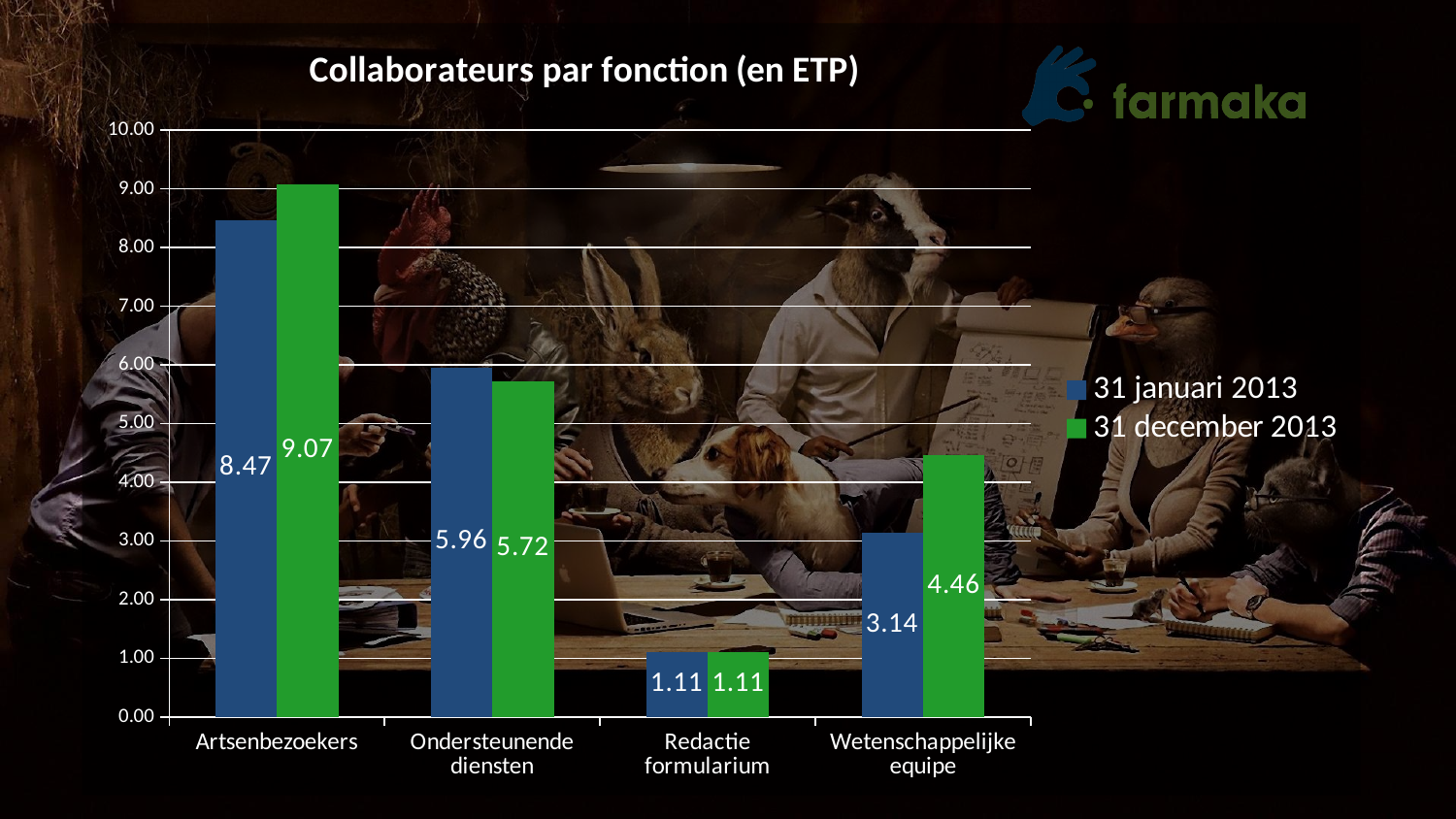
What is the title of the chart? Collaborateurs par fonction (en ETP) Which category has the highest value on 31 januari 2013? Artsenbezoekers What kind of chart is shown on the slide? Bar chart Which category has the lowest value on 31 december 2013? Redactie formularium How many series does the legend list? 2 What is the value for Wetenschappelijke equipe on 31 januari 2013? 3.14 How many categories are shown on the x axis? 4 What is the difference between the 31 december 2013 and 31 januari 2013 values for Wetenschappelijke equipe? 1.32 What is the value for Ondersteunende diensten on 31 december 2013? 5.72 Is the value for Artsenbezoekers on 31 januari 2013 greater or less than 8.00? greater What is the value for Artsenbezoekers on 31 december 2013? 9.07 Which is larger for Ondersteunende diensten: the 31 januari 2013 value or the 31 december 2013 value? 31 januari 2013